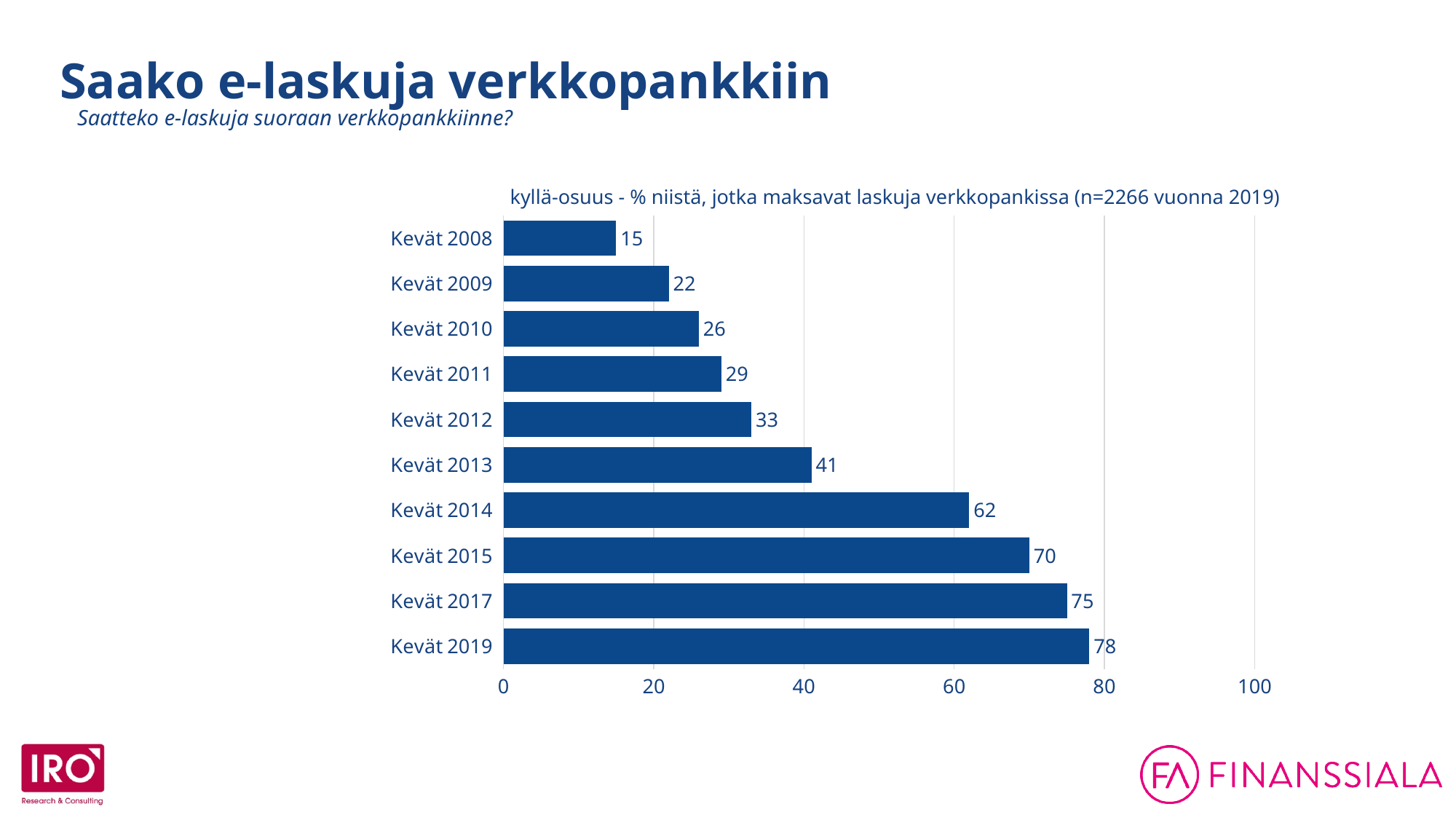
What is the value for Kevät 2008? 15 What is the sample size (n) stated in the chart subtitle for 2019? 2266 Do the values rise or fall from Kevät 2008 to Kevät 2019? rise What is the value for Kevät 2013? 41 Which is larger, the value for Kevät 2012 or the value for Kevät 2011? Kevät 2012 What is the value for Kevät 2017? 75 Is the value for Kevät 2015 greater or less than 60? greater What is the difference between the values for Kevät 2014 and Kevät 2013? 21 What kind of chart is shown on the slide? bar chart How many categories are shown in the chart? 10 Which category has the lowest value? Kevät 2008 Which category has the highest value? Kevät 2019